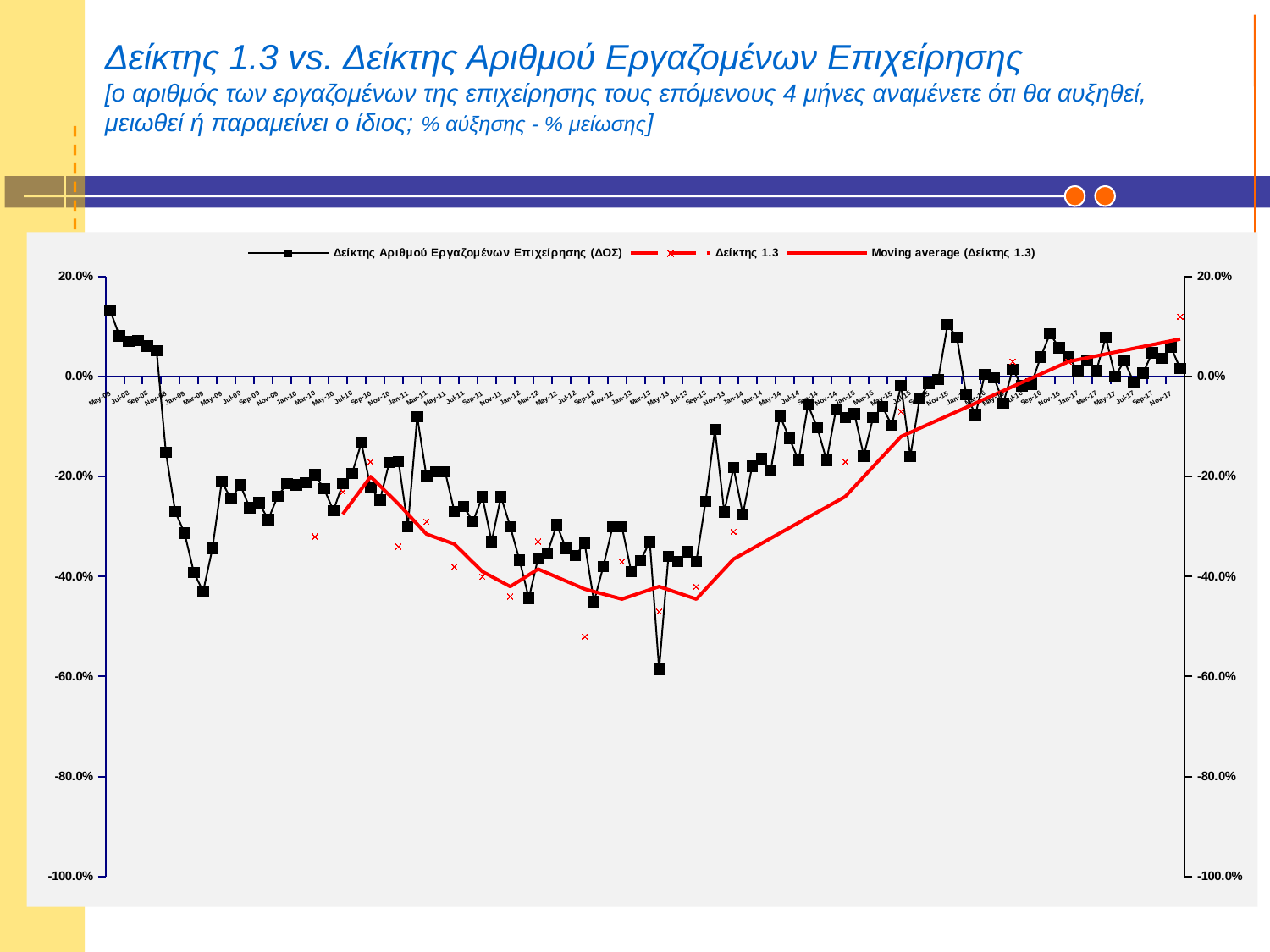
Is the value of the Moving average (Δείκτης 1.3) line around Sep-12 greater or less than -20%? less What kind of chart is shown on the slide? line chart In which year does the Δείκτης Αριθμού Εργαζομένων Επιχείρησης (ΔΟΣ) series reach its lowest value? 2013 Is the value of the Δείκτης Αριθμού Εργαζομένων Επιχείρησης (ΔΟΣ) series at Mar-09 greater or less than -20%? less Is the first value (May-08) of the Δείκτης Αριθμού Εργαζομένων Επιχείρησης (ΔΟΣ) series greater or less than 0%? greater Does the Moving average (Δείκτης 1.3) line rise or fall between Sep-13 and Nov-17? rise Does the Δείκτης Αριθμού Εργαζομένων Επιχείρησης (ΔΟΣ) series rise or fall between May-08 and Mar-09? fall Which series in the legend is drawn with black square markers? Δείκτης Αριθμού Εργαζομένων Επιχείρησης (ΔΟΣ) How many series does the chart legend list? 3 What is the highest value shown on the vertical axis? 20.0%